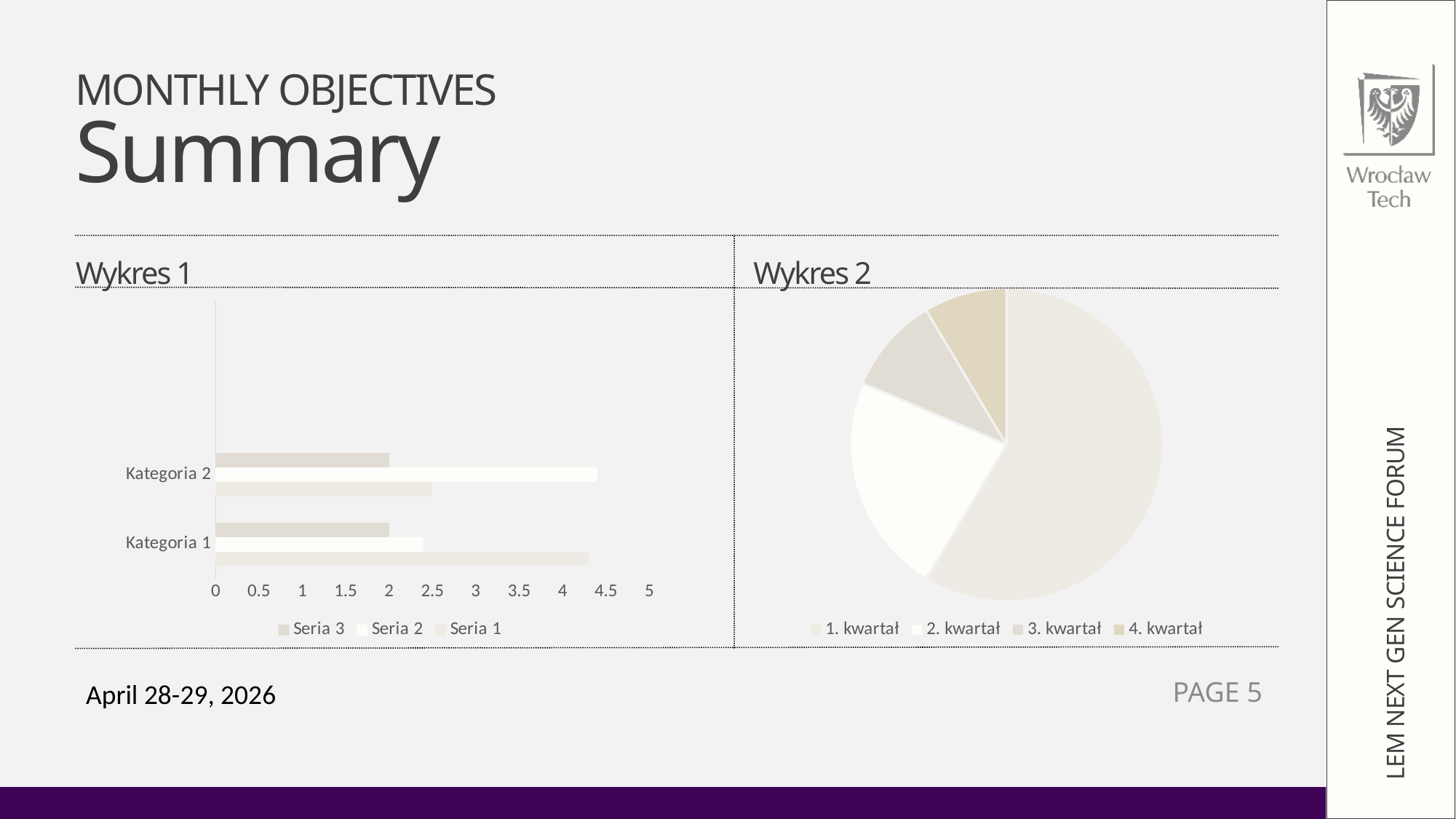
In Wykres 1, how many series does the legend list? 3 In Wykres 1, for Kategoria 2, which is larger: Seria 2 or Seria 1? Seria 2 In Wykres 2, which slice is the largest? 1. kwartał In Wykres 1, which series has the highest value for Kategoria 1? Seria 1 In Wykres 1, is the value of Seria 1 for Kategoria 2 greater or less than 3? less In Wykres 1, how many categories are shown on the vertical axis? 2 In Wykres 2, how many slices does the pie have? 4 What kind of chart is Wykres 2? pie chart In Wykres 1, what is the value of Seria 3 for Kategoria 1? 2 In Wykres 1, is the value of Seria 2 for Kategoria 2 greater or less than 4? greater In Wykres 2, which slice is larger: 2. kwartał or 4. kwartał? 2. kwartał What kind of chart is Wykres 1? bar chart